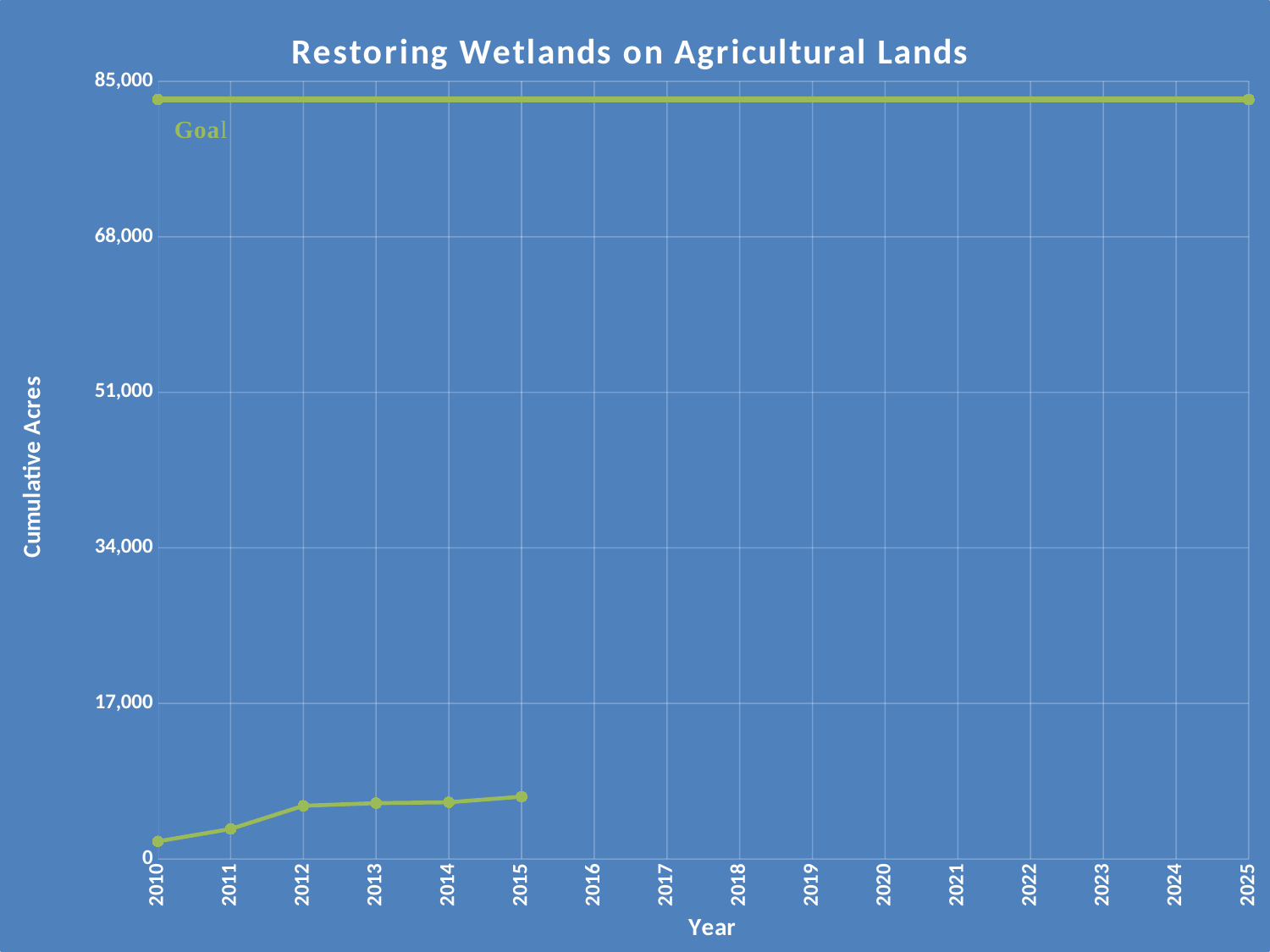
Is the cumulative acres value for 2015 greater or less than 17,000? less Is the cumulative acres value for 2010 greater or less than 17,000? less What is the title of the chart? Restoring Wetlands on Agricultural Lands How many years are labelled along the x axis? 16 Which year has the highest plotted cumulative acres value on the progress line? 2015 Which year has the lowest plotted cumulative acres value on the progress line? 2010 Is the Goal line greater or less than 68,000 cumulative acres? greater How many data points are plotted on the cumulative acres progress line? 6 What is the label of the vertical axis? Cumulative Acres What kind of chart is shown on the slide? line chart Which is larger, the cumulative acres value for 2010 or for 2012? 2012 Do the plotted cumulative acres values rise or fall from 2010 to 2015? rise